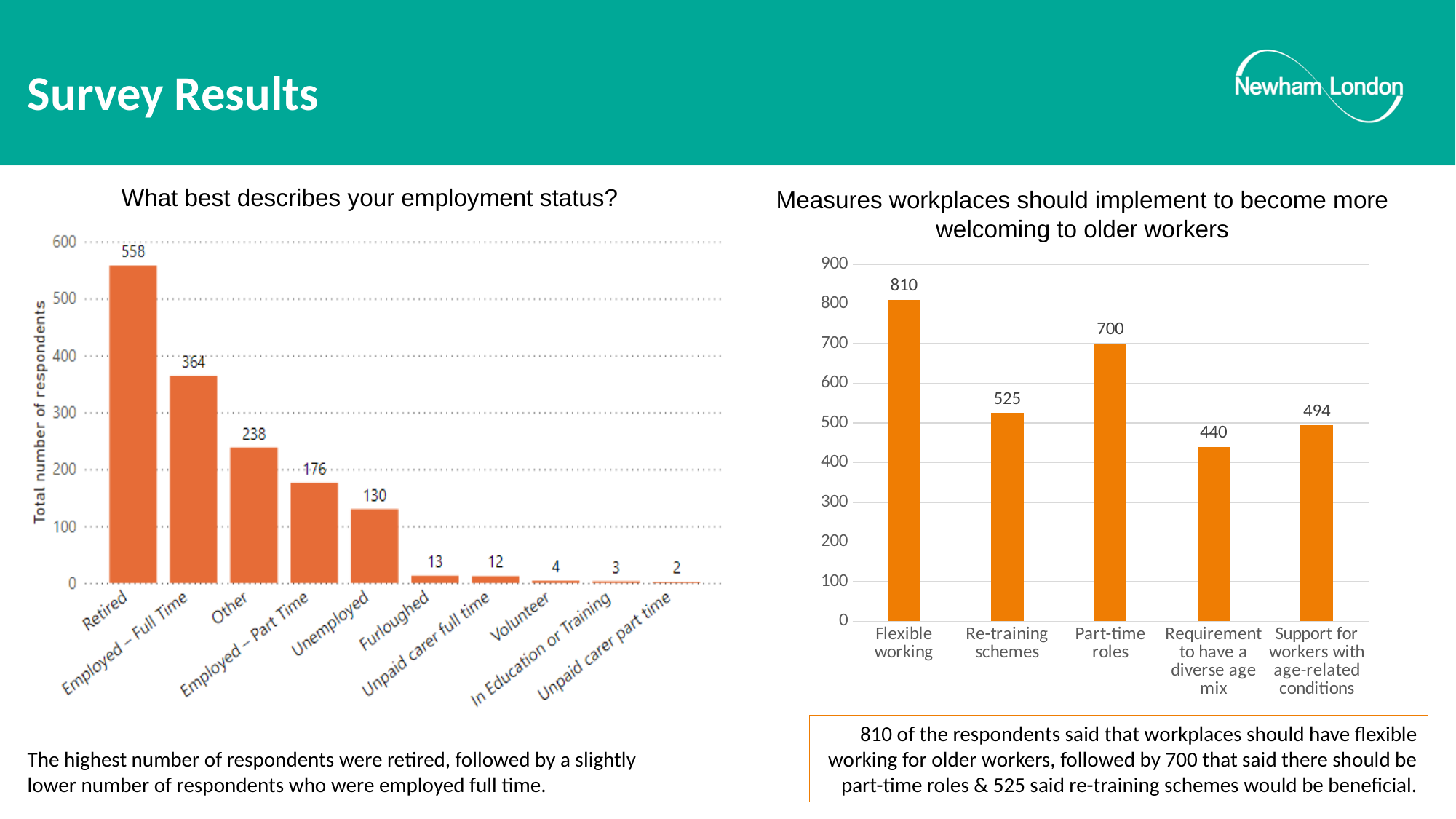
In the 'Measures workplaces should implement' chart, which measure has the lowest value? Requirement to have a diverse age mix In the 'What best describes your employment status?' chart, how many respondents were Employed – Part Time? 176 In the 'Measures workplaces should implement' chart, what is the value for Re-training schemes? 525 In the 'Measures workplaces should implement' chart, what is the difference between Flexible working and Part-time roles? 110 In the 'What best describes your employment status?' chart, which category has the lowest number of respondents? Unpaid carer part time In the 'What best describes your employment status?' chart, how many categories are shown? 10 In the 'Measures workplaces should implement' chart, how many measures are shown? 5 In the 'What best describes your employment status?' chart, how many respondents were Retired? 558 What type of chart is the 'Measures workplaces should implement' chart? Bar chart In the 'What best describes your employment status?' chart, which is larger, Other or Unemployed? Other In the 'Measures workplaces should implement' chart, which measure has the highest value? Flexible working In the 'What best describes your employment status?' chart, what is the difference between Retired and Employed – Full Time? 194